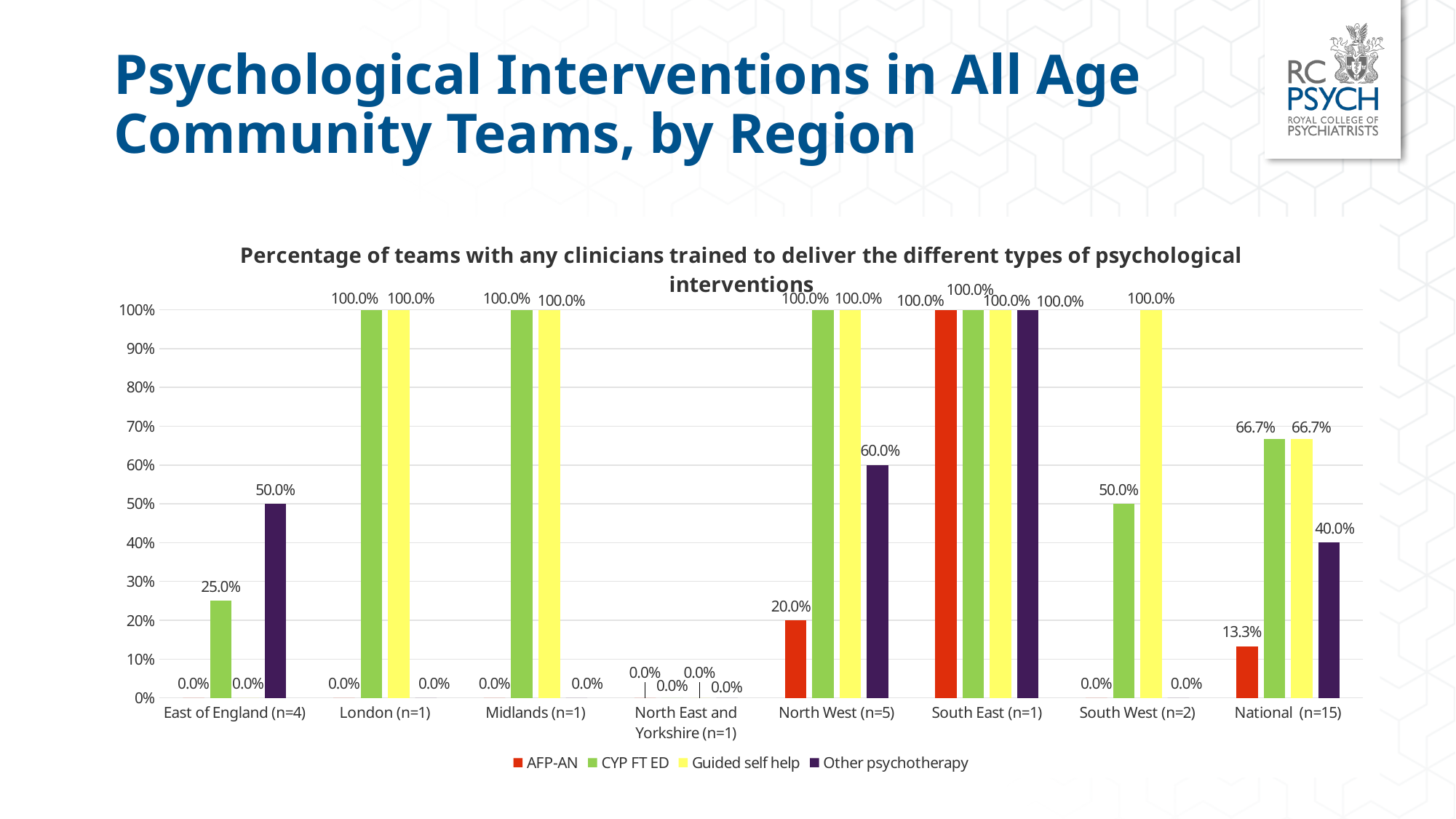
What kind of chart is shown on the slide? Bar chart What is the value for CYP FT ED in South West (n=2)? 50.0% What is the difference between the Other psychotherapy value for North West (n=5) and for National (n=15)? 20.0% How many regions (categories) are shown on the x axis? 8 What is the difference between the CYP FT ED value and the AFP-AN value for National (n=15)? 53.4% How many series does the legend list? 4 What is the value for AFP-AN in National (n=15)? 13.3% Which region has the highest value for AFP-AN? South East (n=1) Which is larger for North West (n=5): the AFP-AN value or the Other psychotherapy value? Other psychotherapy What is the value for Other psychotherapy in North West (n=5)? 60.0% Which series is shown in yellow in the legend? Guided self help What is the value for Other psychotherapy in East of England (n=4)? 50.0%